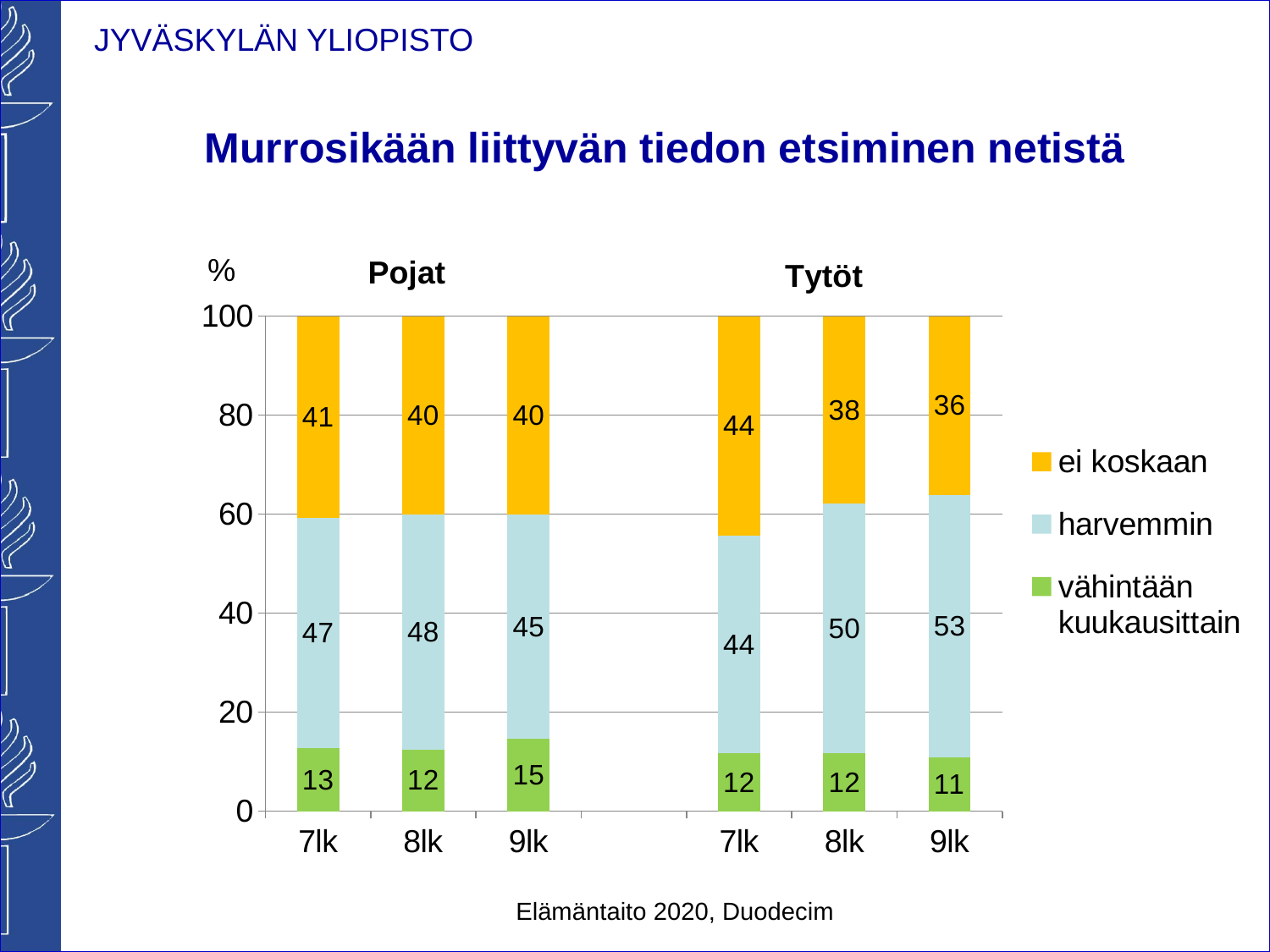
What type of chart is shown on the slide? Stacked bar chart What is the 'harvemmin' value for Tytöt in 9lk? 53 Among the Tytöt bars, which grade has the highest 'harvemmin' value? 9lk What is the difference between the 'ei koskaan' values for Tytöt 7lk and Tytöt 9lk? 8 How many series does the legend list? 3 Among all six bars, which group and grade has the lowest 'vähintään kuukausittain' value? Tytöt 9lk What percentage of Pojat in 9lk search for puberty-related information online at least monthly (vähintään kuukausittain)? 15 Which is larger: the 'harvemmin' value for Pojat 8lk or for Tytöt 8lk? Tytöt 8lk What is the 'ei koskaan' value for Pojat in 7lk? 41 Which legend entry is shown in orange? ei koskaan How many bars are shown in the chart in total? 6 What is the 'ei koskaan' value for Tytöt in 7lk? 44